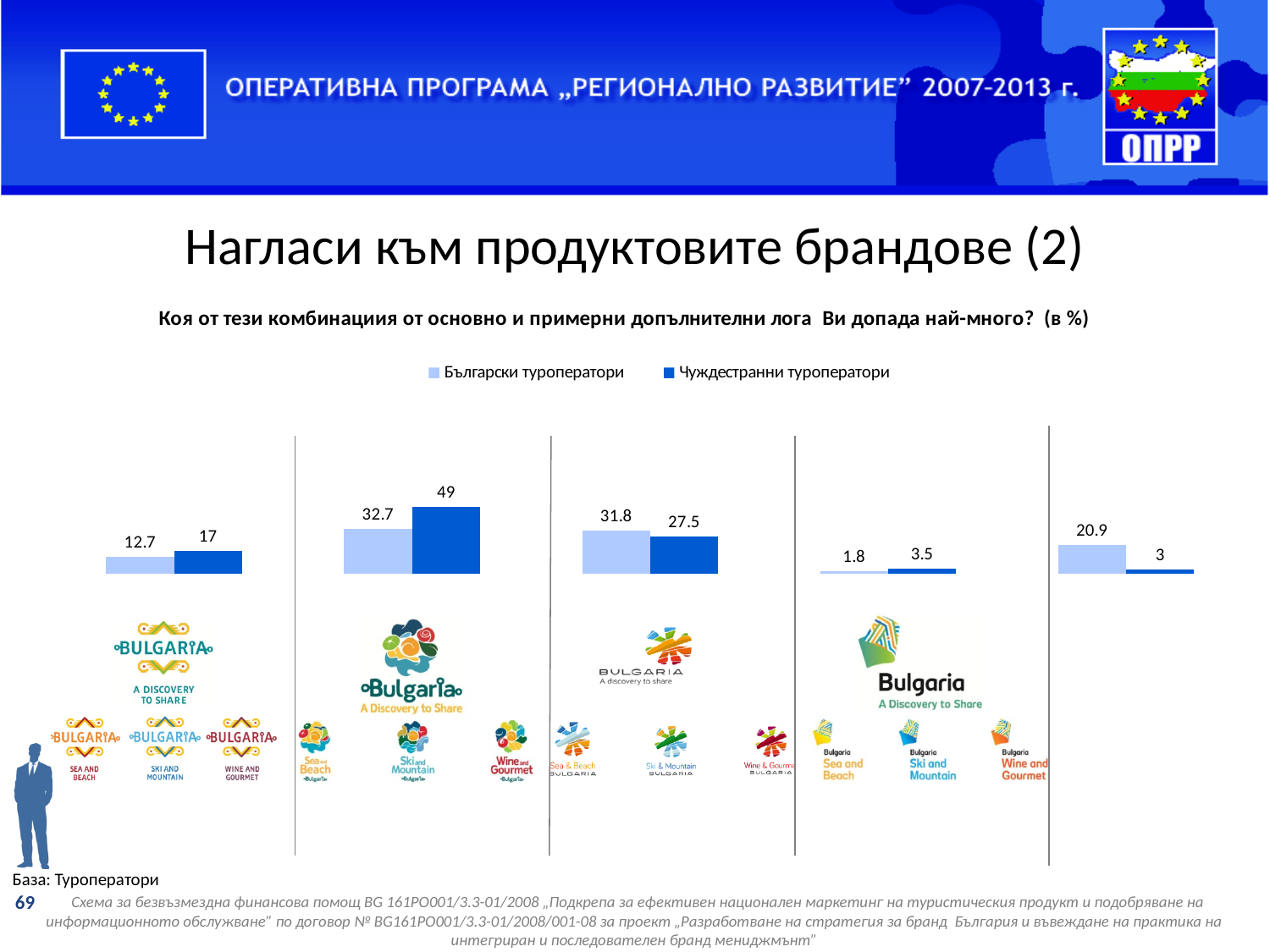
Which series is shown in the darker blue colour in the legend? Чуждестранни туроператори What type of chart is shown on the slide? bar chart Which logo combination has the highest value for Чуждестранни туроператори? the second from the left What is the value for Български туроператори in the third logo combination from the left? 31.8 What is the difference between the Чуждестранни туроператори and Български туроператори values in the second logo combination from the left? 16.3 Which logo combination has the lowest value for Български туроператори? the fourth from the left How many logo combinations (category groups) are shown in the chart? 5 What is the value for Чуждестранни туроператори in the second logo combination from the left? 49 How many series does the chart legend list? 2 What is the value for Български туроператори in the rightmost logo combination? 20.9 What is the difference between the Български туроператори and Чуждестранни туроператори values in the leftmost logo combination? 4.3 In the rightmost logo combination, which series has the larger value: Български туроператори or Чуждестранни туроператори? Български туроператори